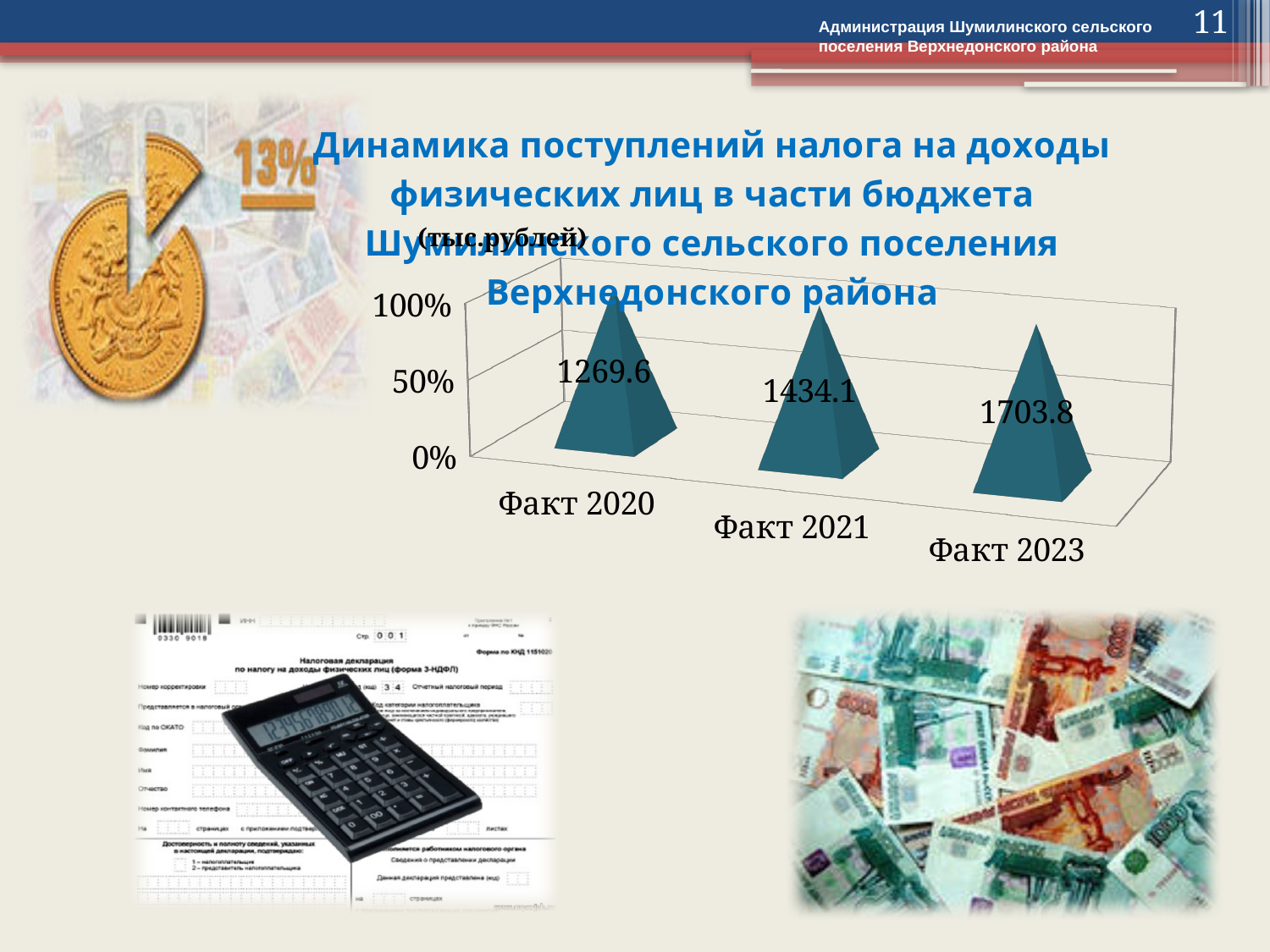
What is the value for Факт 2020? 1269.6 Do the values rise or fall from Факт 2020 to Факт 2023? rise What is the difference between the values for Факт 2021 and Факт 2020? 164.5 What unit is given in parentheses under the chart title? тыс.рублей Which is larger, the value for Факт 2021 or the value for Факт 2023? Факт 2023 Which category has the lowest value? Факт 2020 Which category has the highest value? Факт 2023 How many categories are shown on the chart? 3 What is the difference between the values for Факт 2023 and Факт 2021? 269.7 What is the difference between the values for Факт 2023 and Факт 2020? 434.2 What is the value for Факт 2021? 1434.1 What is the value for Факт 2023? 1703.8